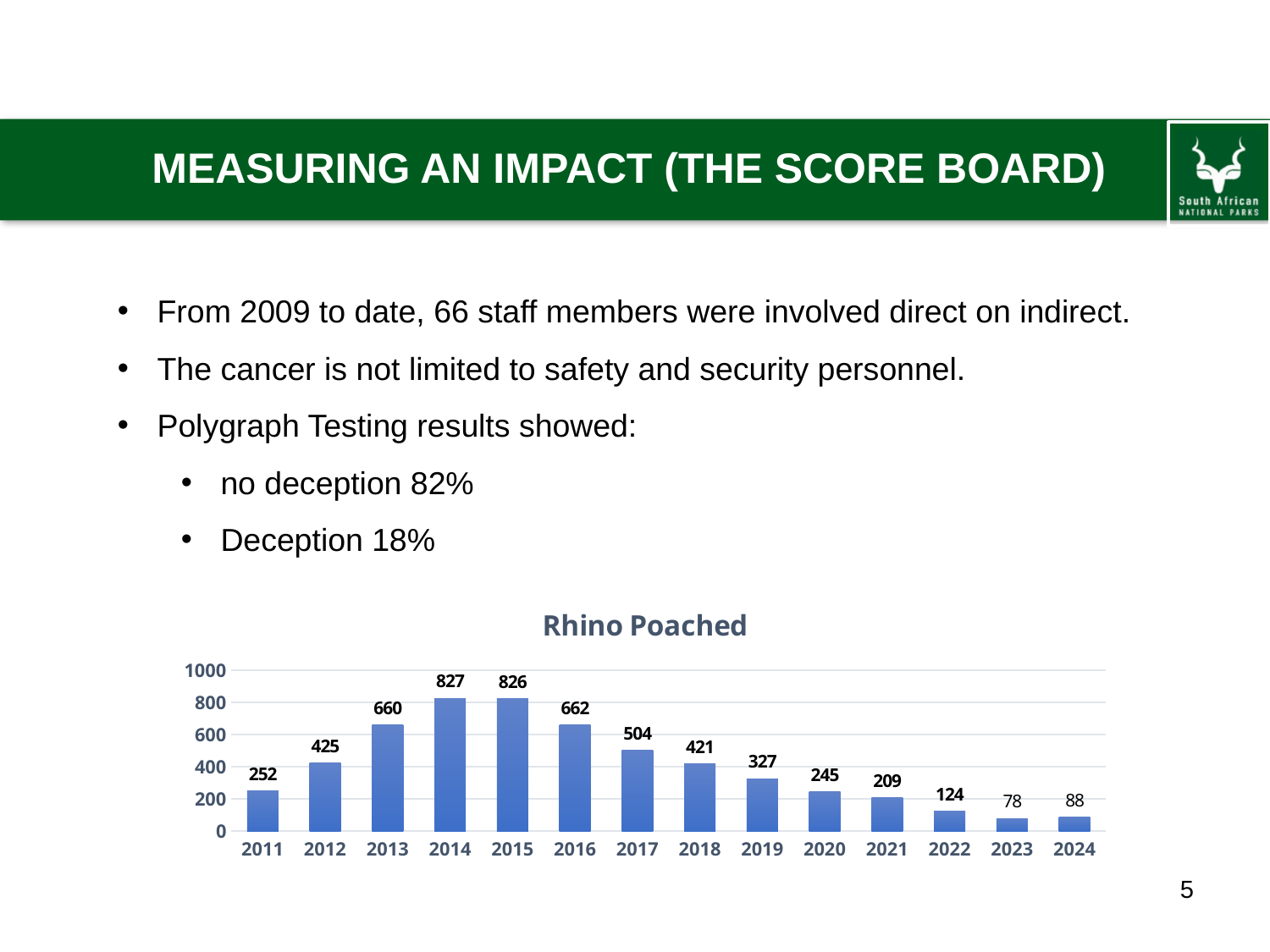
What is the difference between the values for 2013 and 2011 in the Rhino Poached chart? 408 Which is larger in the Rhino Poached chart, the value for 2017 or the value for 2018? 2017 What is the title of the chart on the slide? Rhino Poached What is the value for 2019 in the Rhino Poached chart? 327 What kind of chart is the Rhino Poached chart? bar chart What is the value for 2023 in the Rhino Poached chart? 78 Which year has the highest value in the Rhino Poached chart? 2014 Do the values in the Rhino Poached chart rise or fall from 2014 to 2023? fall Is the value for 2016 in the Rhino Poached chart greater or less than 600? greater How many years are shown on the x axis of the Rhino Poached chart? 14 What is the value for 2014 in the Rhino Poached chart? 827 Which year has the lowest value in the Rhino Poached chart? 2023